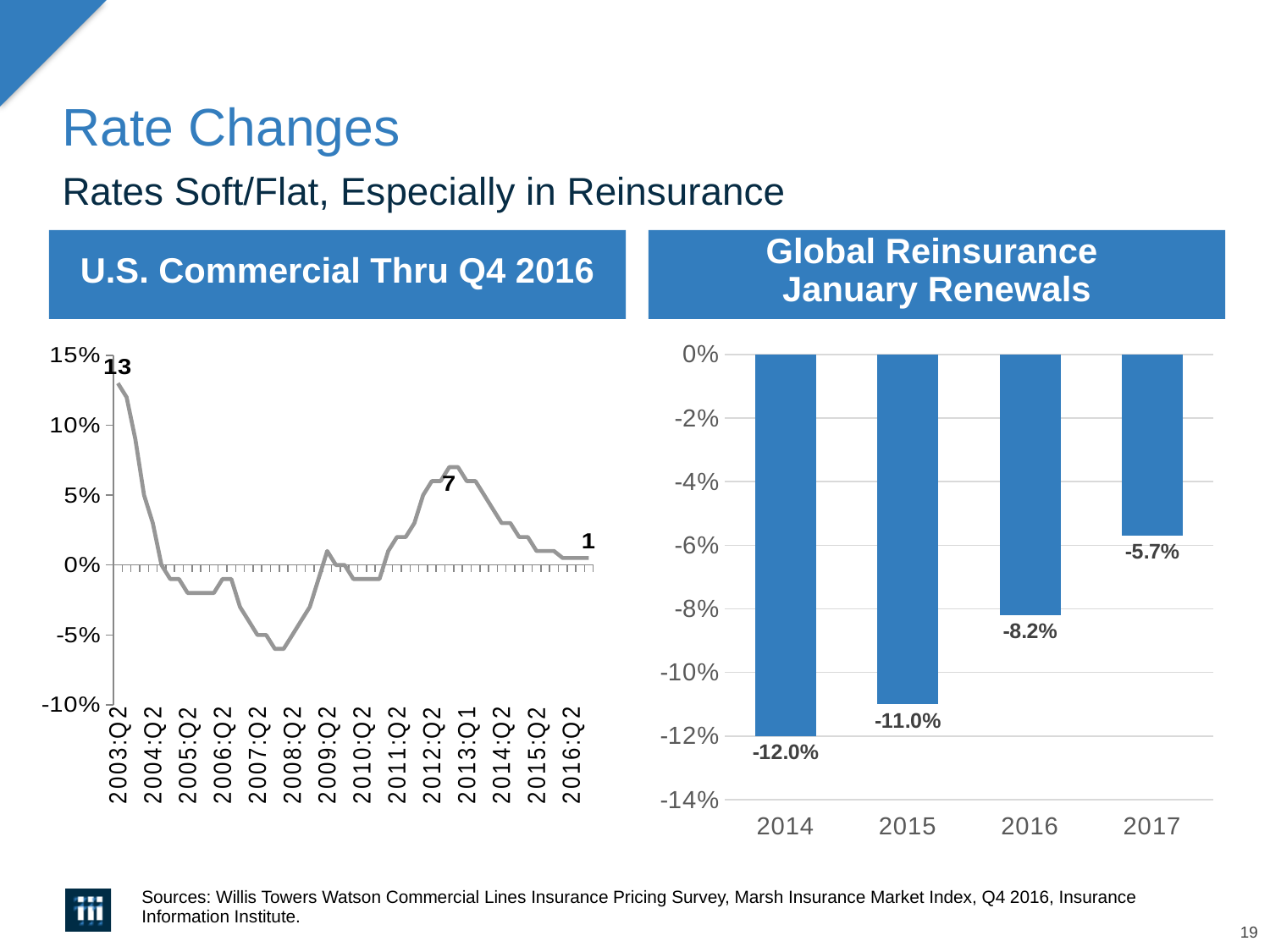
In the Global Reinsurance January Renewals chart, how many years are shown? 4 In the U.S. Commercial Thru Q4 2016 chart, what is the labelled value at the end of the series in 2016? 1 In the Global Reinsurance January Renewals chart, which year has the highest (least negative) value? 2017 In the Global Reinsurance January Renewals chart, what is the difference between the 2015 and 2016 values? 2.8 percentage points In the Global Reinsurance January Renewals chart, what is the value for 2014? -12.0% What kind of chart is the U.S. Commercial Thru Q4 2016 chart? line chart In the U.S. Commercial Thru Q4 2016 chart, what is the labelled value at the start of the series in 2003:Q2? 13 In the Global Reinsurance January Renewals chart, what is the value for 2016? -8.2% In the Global Reinsurance January Renewals chart, what is the value for 2017? -5.7% What kind of chart is the Global Reinsurance January Renewals chart? bar chart In the Global Reinsurance January Renewals chart, do the values rise or fall from 2014 to 2017? rise In the Global Reinsurance January Renewals chart, which year has the lowest (most negative) value? 2014